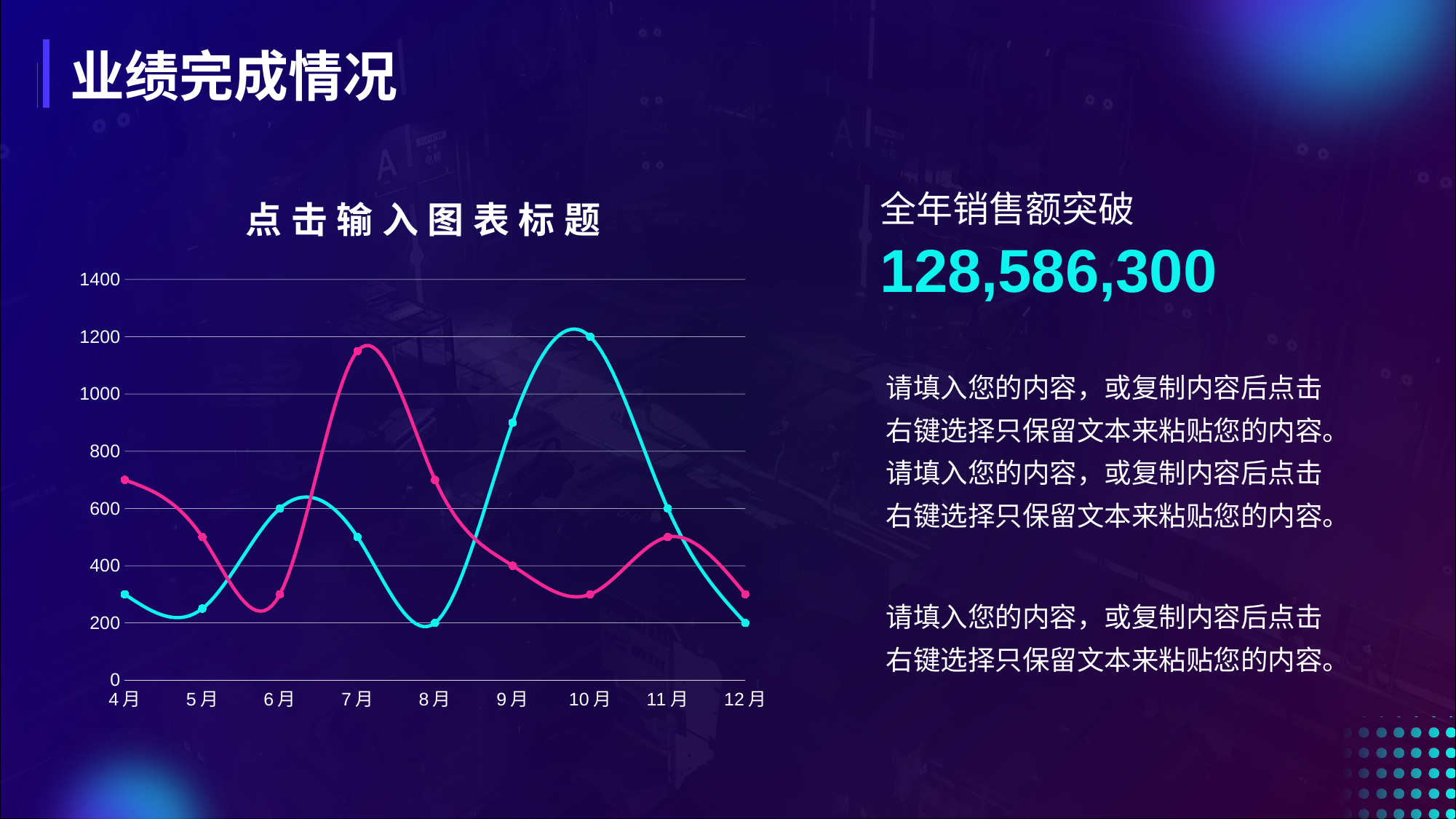
How many lines are plotted in the chart? 2 In which month does the cyan line reach its highest value? 10月 Is the value of the pink line in 7月 greater or less than 1000? greater In which month does the pink line reach its highest value? 7月 Does the cyan line rise or fall from 10月 to 12月? fall In 10月, which line has the higher value, the pink line or the cyan line? the cyan line Is the value of the cyan line in 5月 greater or less than 400? less What is the value of the cyan line in 6月? 600 How many months are shown on the x axis of the chart? 9 What kind of chart is shown on the slide? line chart What is the title of the chart? 点击输入图表标题 What is the value of the cyan line in 8月? 200